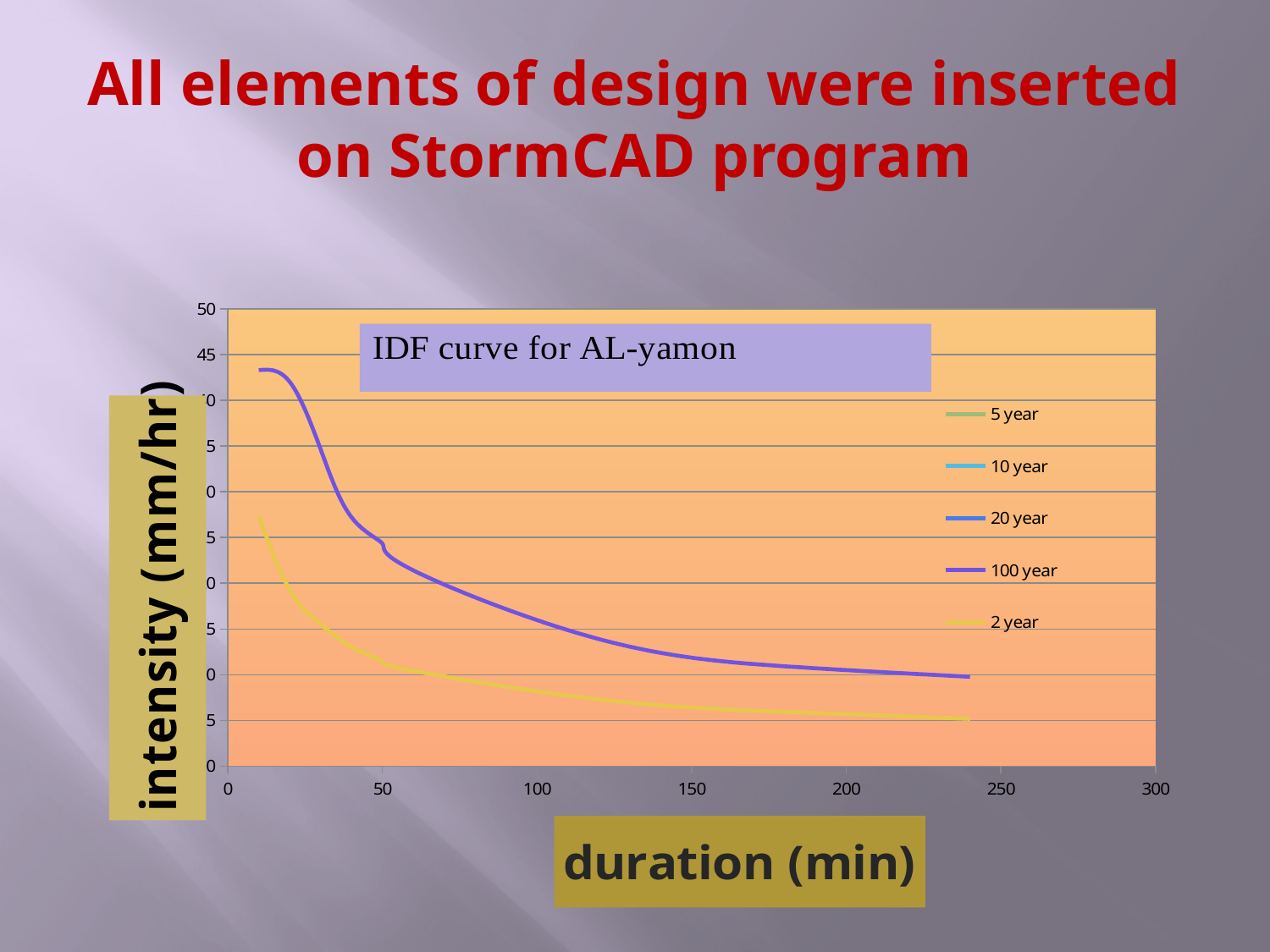
What is the label of the x axis? duration (min) What is the title shown inside the chart? IDF curve for AL-yamon How many series does the chart legend list? 5 Do the plotted curves rise or fall as duration increases along the x axis? fall Is the intensity of the 100 year curve at a duration of 50 min greater or less than 20? greater What is the highest value shown on the x axis? 300 At a duration of 100 min, which curve has the higher intensity, 100 year or 2 year? 100 year Is the intensity of the 100 year curve at a duration of 100 min greater or less than 10? greater What kind of chart is shown on the slide? line chart Is the intensity of the 2 year curve at a duration of 100 min greater or less than 10? less At a duration of 200 min, which curve has the lower intensity, 100 year or 2 year? 2 year